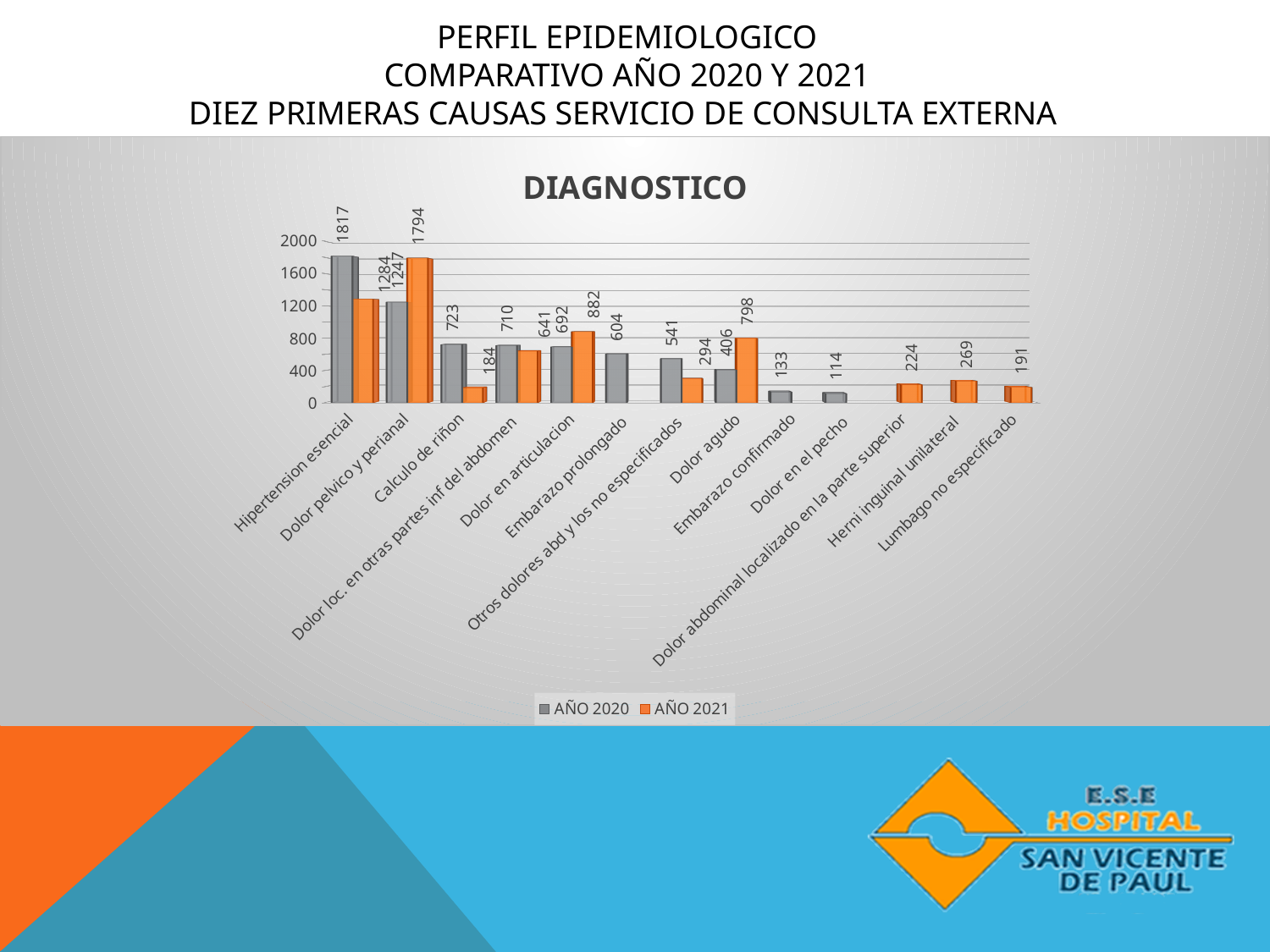
How many series does the legend list? 2 What is the AÑO 2020 value for Hipertension esencial? 1817 How many categories are shown on the x axis? 13 Which is larger for Dolor en articulacion, the AÑO 2020 value or the AÑO 2021 value? AÑO 2021 What is the difference between the AÑO 2020 and AÑO 2021 values for Hipertension esencial? 533 What is the title of the chart? DIAGNOSTICO What is the AÑO 2020 value for Dolor agudo? 406 What kind of chart is shown on the slide? Bar chart What is the AÑO 2021 value for Calculo de riñon? 184 Which category has the highest AÑO 2020 value? Hipertension esencial Which category has the lowest AÑO 2021 value? Calculo de riñon What is the AÑO 2021 value for Dolor pelvico y perianal? 1794